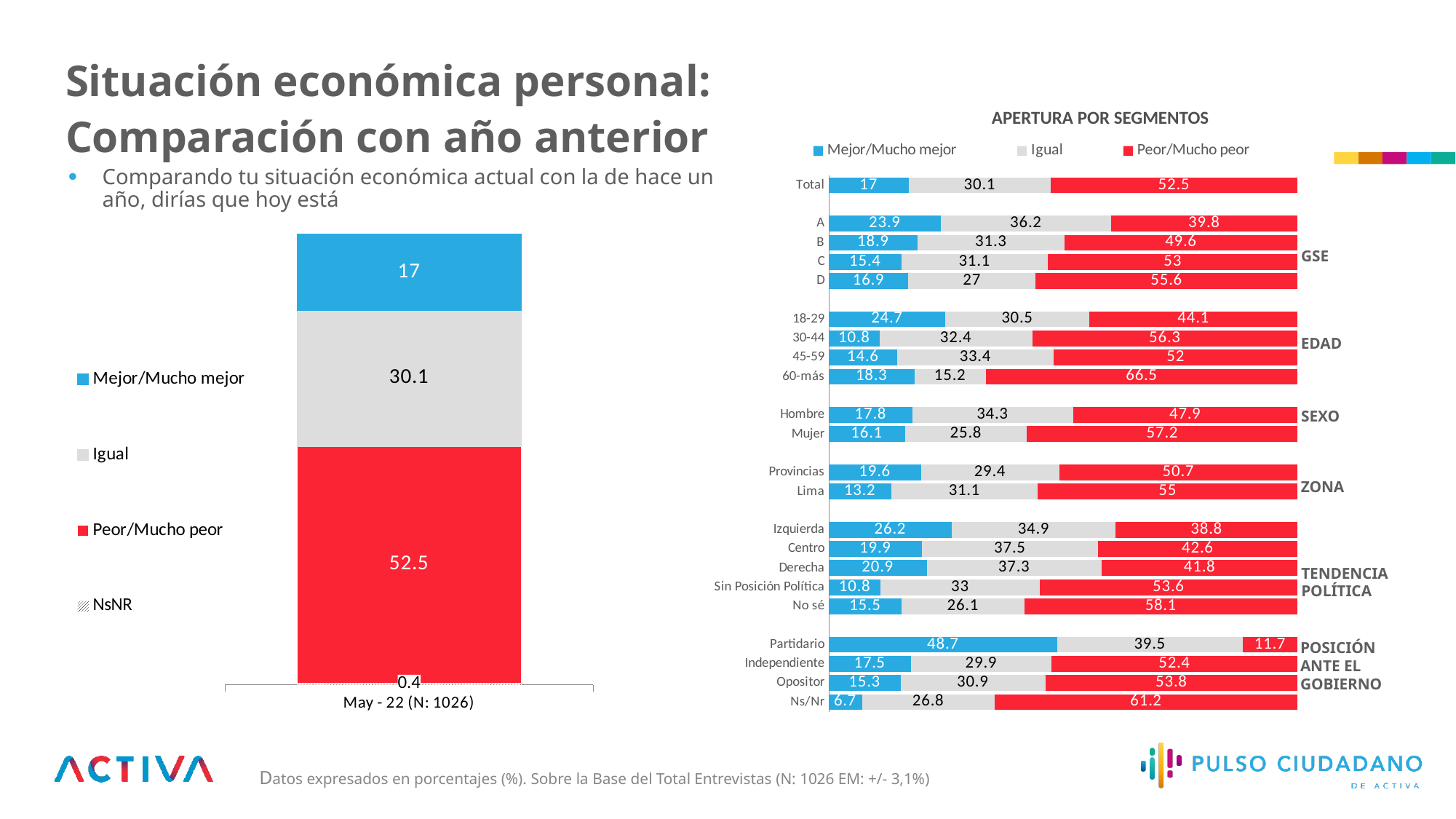
In the left chart (May - 22), what is the value for Peor/Mucho peor? 52.5 In the left chart, how many series does the legend list? 4 In the APERTURA POR SEGMENTOS chart, how many series does the legend list? 3 In the left chart (May - 22), what is the value for NsNR? 0.4 In the APERTURA POR SEGMENTOS chart, which has a larger Igual value, Centro or Derecha? Centro What kind of chart is the chart titled APERTURA POR SEGMENTOS? Stacked bar chart In the APERTURA POR SEGMENTOS chart, which category has the highest Mejor/Mucho mejor value? Partidario In the APERTURA POR SEGMENTOS chart, what is the Peor/Mucho peor value for 60-más? 66.5 In the APERTURA POR SEGMENTOS chart, what is the Igual value for Lima? 31.1 In the APERTURA POR SEGMENTOS chart, which category has the lowest Peor/Mucho peor value? Partidario In the APERTURA POR SEGMENTOS chart, what is the difference between the Peor/Mucho peor values for Mujer and Hombre? 9.3 In the APERTURA POR SEGMENTOS chart, what is the Mejor/Mucho mejor value for Partidario? 48.7